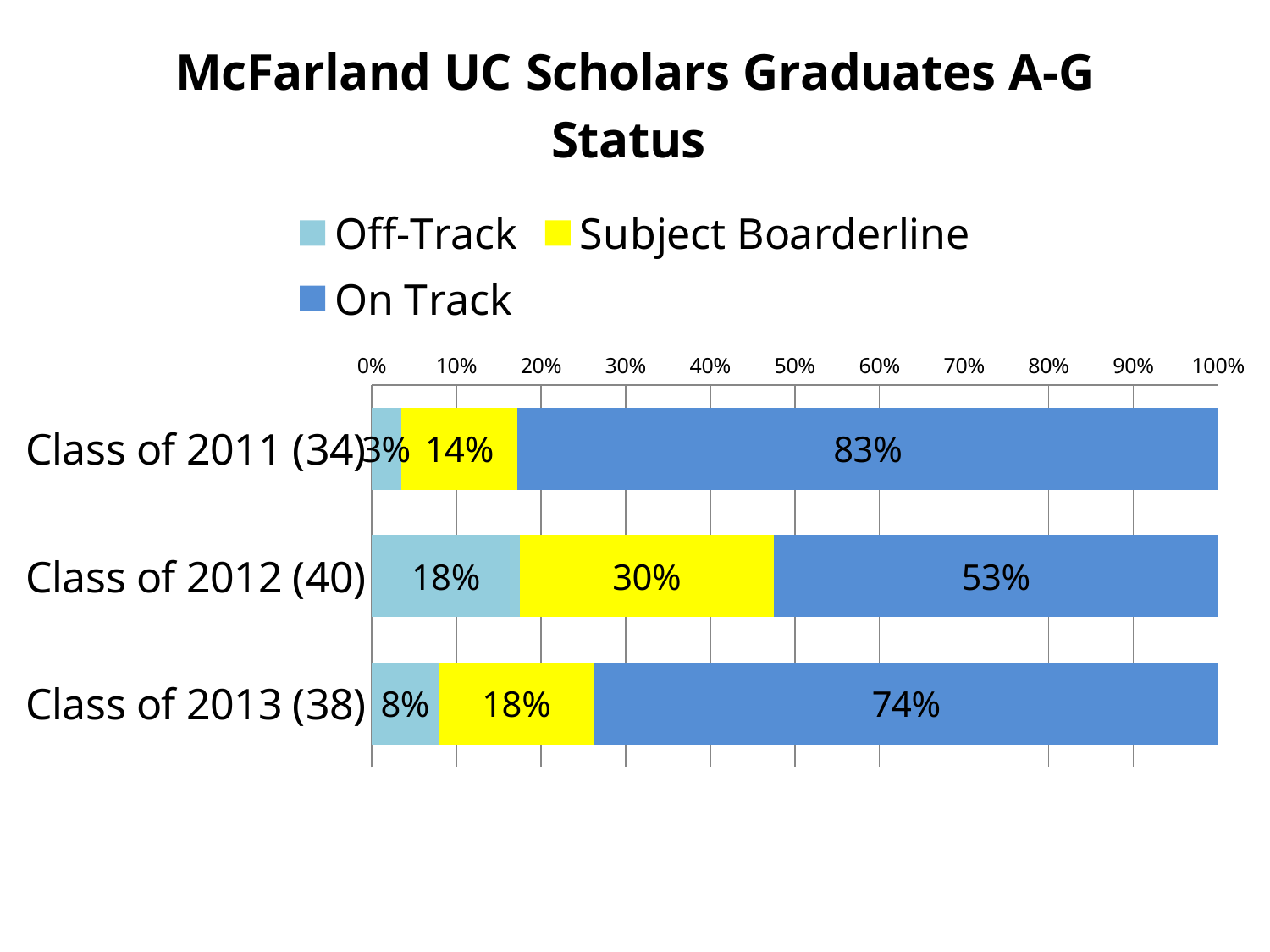
How many classes are shown on the chart? 3 What is the On Track value for Class of 2011 (34)? 83% Which class has the lowest Off-Track percentage? Class of 2011 (34) What is the title of the chart? McFarland UC Scholars Graduates A-G Status What is the Off-Track value for Class of 2013 (38)? 8% How many series does the legend list? 3 Which is larger: the Subject Boarderline value for Class of 2013 (38) or for Class of 2011 (34)? Class of 2013 (38) What kind of chart is shown on the slide? Stacked bar chart What is the difference between the On Track values for Class of 2011 (34) and Class of 2012 (40)? 30% What is the Off-Track value for Class of 2012 (40)? 18% What is the Subject Boarderline value for Class of 2012 (40)? 30% Which class has the highest On Track percentage? Class of 2011 (34)